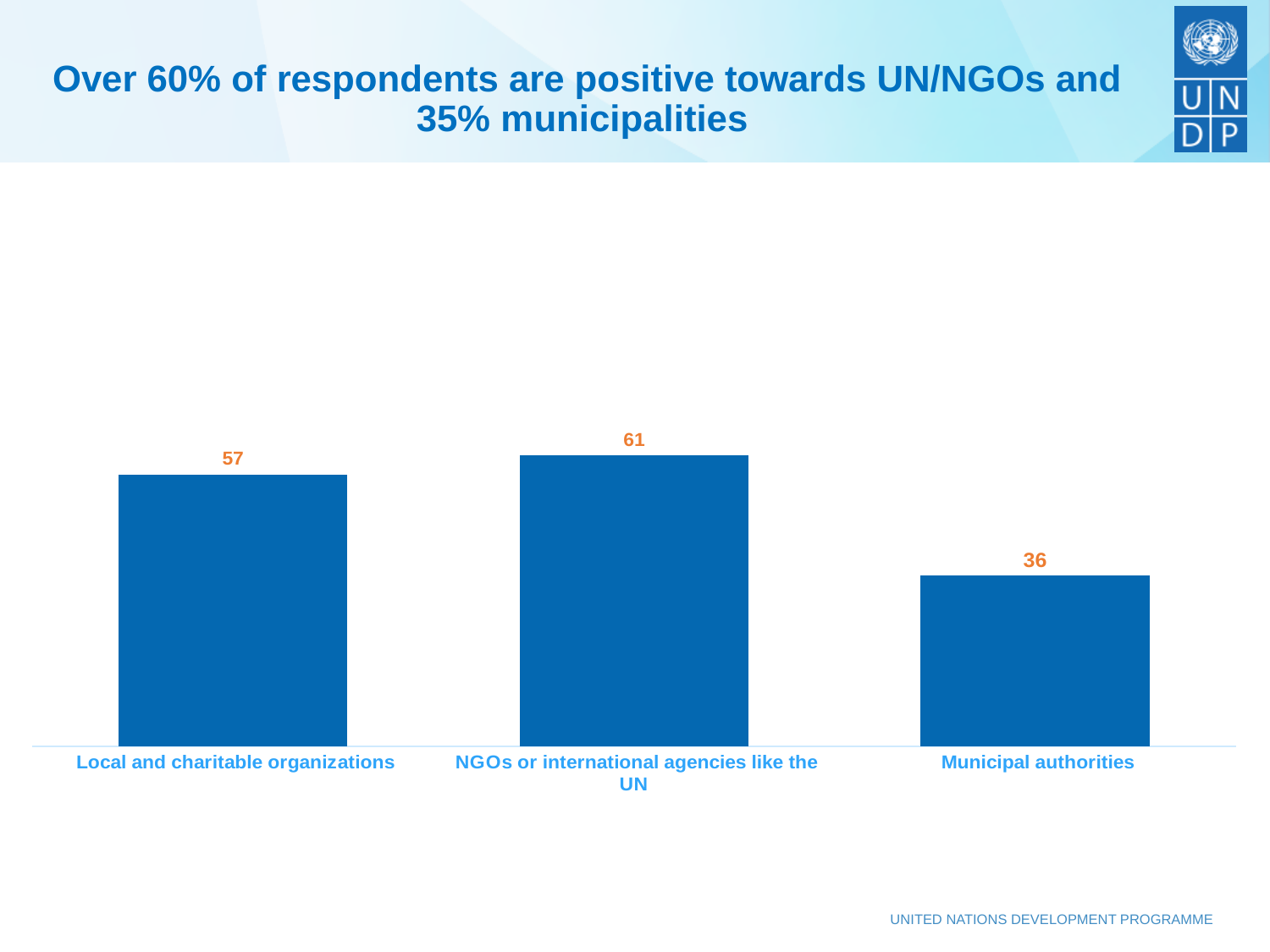
What is the value for NGOs or international agencies like the UN? 61 What is the difference between the values for NGOs or international agencies like the UN and Municipal authorities? 25 What is the value for Municipal authorities? 36 How many categories are shown in the chart? 3 Which category has the lowest value? Municipal authorities What colour are the bars in the chart? Blue What is the value for Local and charitable organizations? 57 Which is larger, the value for Local and charitable organizations or the value for Municipal authorities? Local and charitable organizations What is the title of the slide? Over 60% of respondents are positive towards UN/NGOs and 35% municipalities Which category has the highest value? NGOs or international agencies like the UN What kind of chart is shown on the slide? Bar chart What is the difference between the values for NGOs or international agencies like the UN and Local and charitable organizations? 4